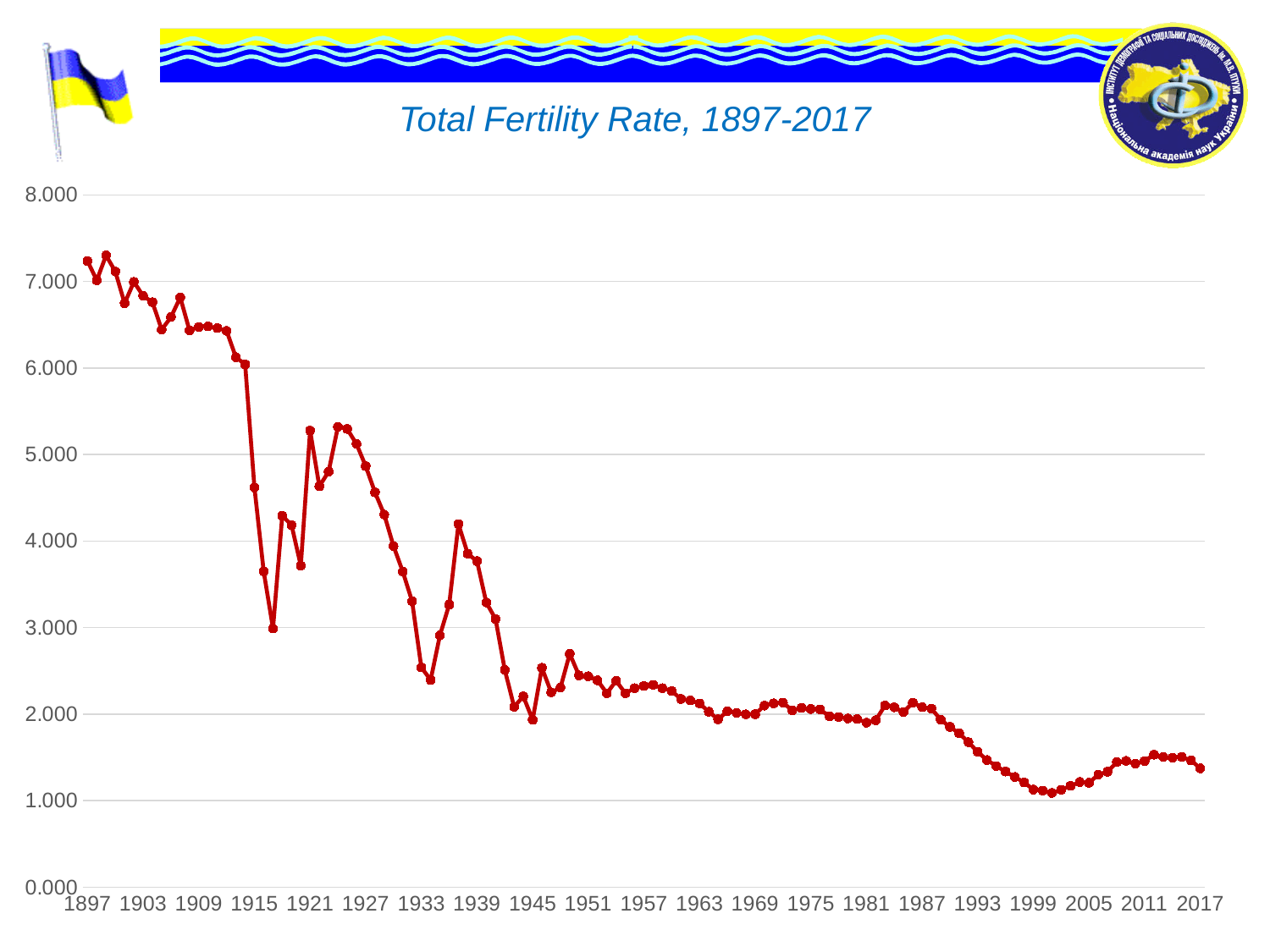
Which year has the larger value, 1921 or 1939? 1921 What is the title of the chart? Total Fertility Rate, 1897-2017 Is the value for 1999 greater or less than 2.000? less Is the value for 2017 greater or less than 2.000? less What kind of chart is shown on the slide? line chart Overall, do the values rise or fall from 1897 to 2017? fall Is the value for 1897 greater or less than 7.000? greater Which year has the larger value, 1897 or 2017? 1897 Which year has the larger value, 1951 or 1999? 1951 What colour is the plotted line? red